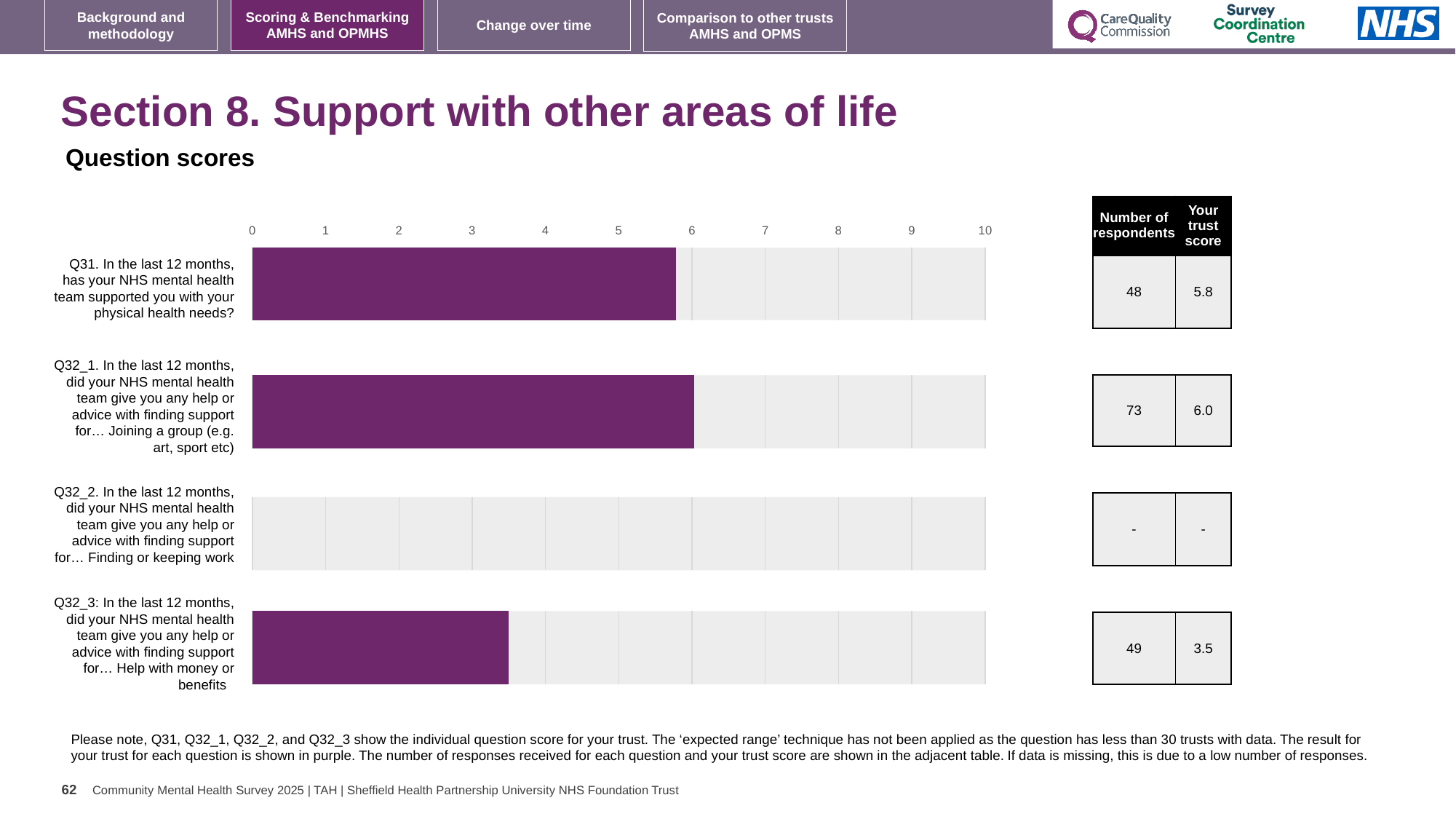
What is the trust score for Q31 (support with physical health needs)? 5.8 What is the trust score for Q32_3 (help with money or benefits)? 3.5 How many respondents answered Q32_1? 73 What is the trust score for Q32_1 (help with joining a group)? 6.0 Is the trust score for Q32_3 greater or less than 4? less What kind of chart is shown on the slide? Bar chart Which question with a plotted bar has the lowest trust score? Q32_3 Which has a higher trust score, Q31 or Q32_3? Q31 What is the difference between the trust scores for Q32_1 and Q32_3? 2.5 How many questions are listed on the chart? 4 Which question has the highest trust score? Q32_1 How many respondents answered Q31? 48